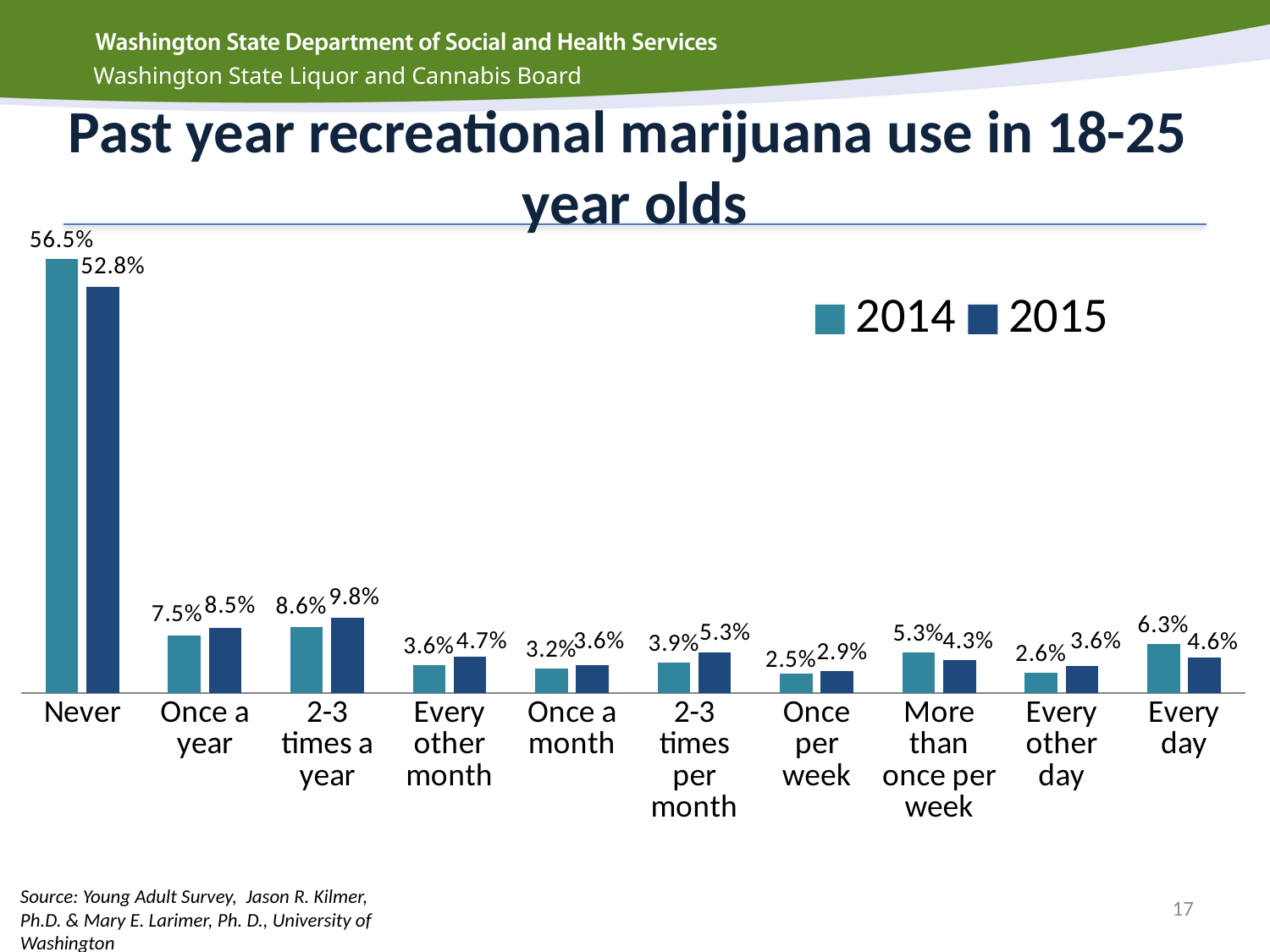
What are the two series listed in the legend? 2014 and 2015 What was the value for "2-3 times per month" in 2015? 5.3% What was the value for "More than once per week" in 2014? 5.3% Which category has the highest value in 2015? Never How many categories are shown on the x axis? 10 What kind of chart is shown on the slide? Bar chart What was the value for "Never" in 2014? 56.5% What is the difference between the 2014 and 2015 values for "Never"? 3.7% How many series does the legend list? 2 Which is larger for "Every day": the 2014 value or the 2015 value? 2014 What was the value for "Every day" in 2015? 4.6% Which category has the lowest value in 2014? Once per week